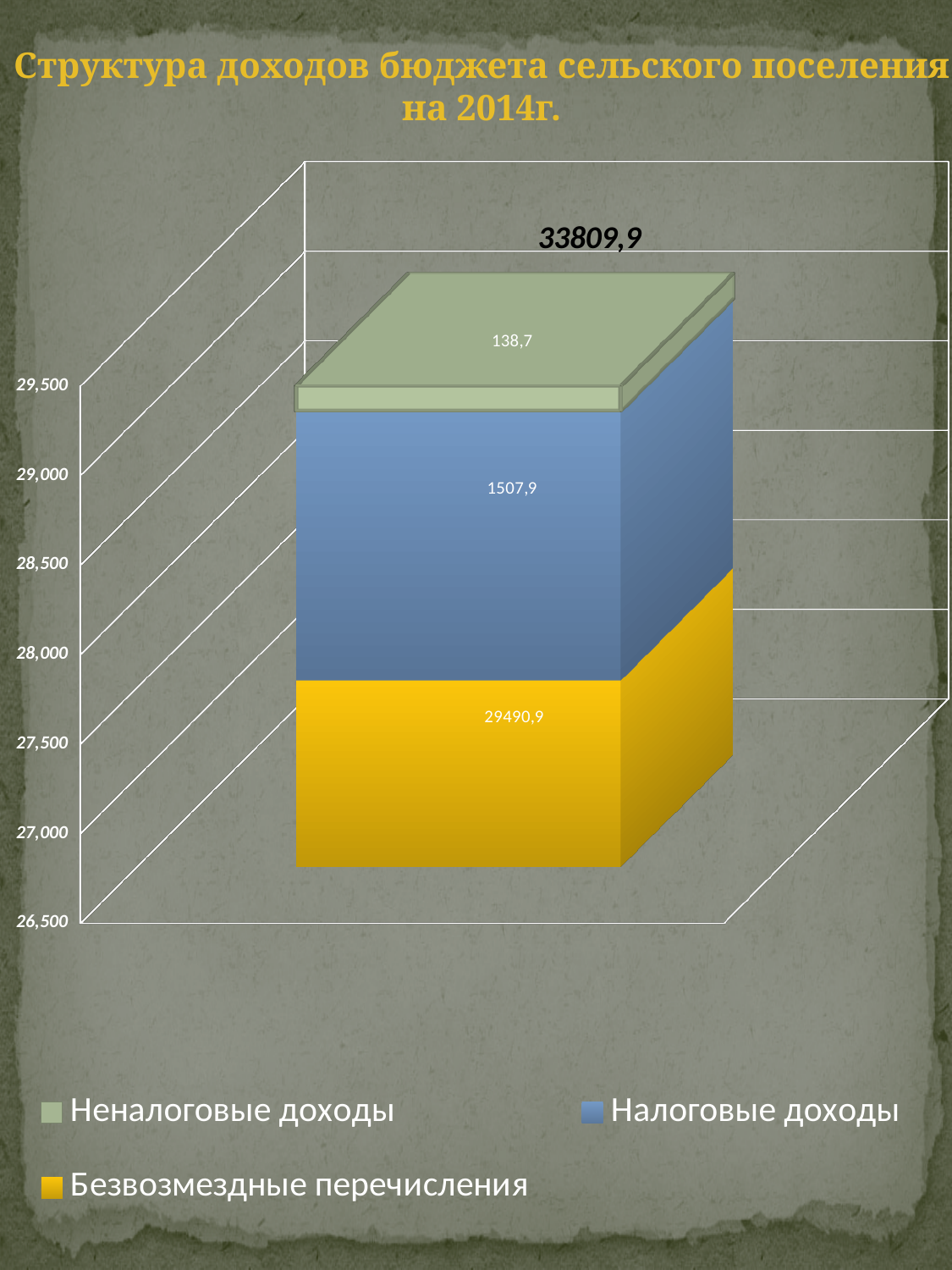
Which is larger, Налоговые доходы or Неналоговые доходы? Налоговые доходы What colour represents Безвозмездные перечисления in the legend? Yellow What kind of chart is shown on the slide? Stacked bar chart How many series does the legend list? 3 What is the value for Неналоговые доходы? 138,7 What is the title of the chart? Структура доходов бюджета сельского поселения на 2014г. What is the total of the stacked bar as printed on the chart? 33809,9 What is the difference between Налоговые доходы and Неналоговые доходы? 1369,2 Which series has the smallest value in the stacked bar? Неналоговые доходы Which series has the largest value in the stacked bar? Безвозмездные перечисления What is the value for Налоговые доходы? 1507,9 What is the value for Безвозмездные перечисления? 29490,9